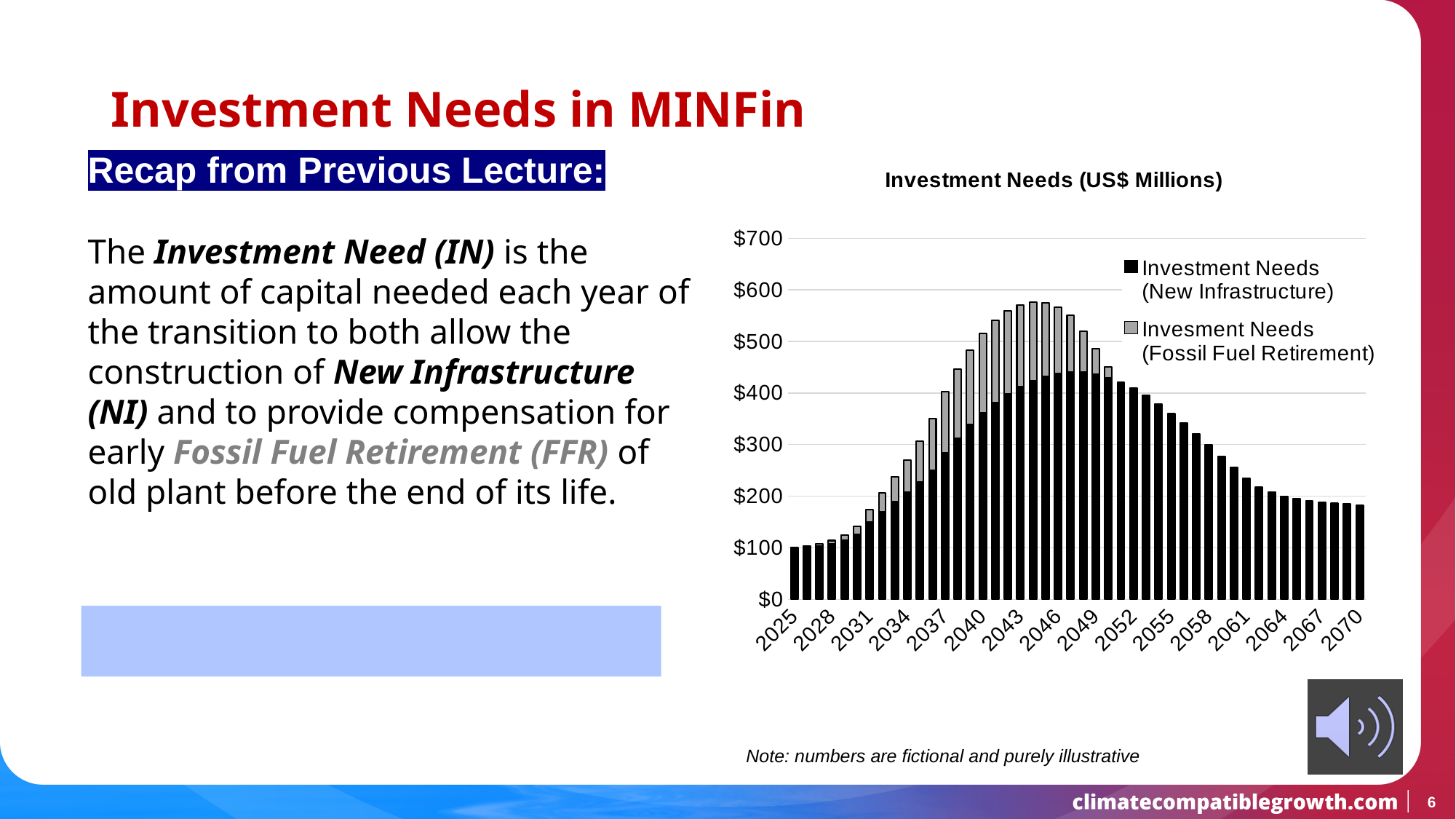
How many series does the chart's legend list? 2 Is the total investment need for 2046 greater or less than $500? greater Is the total investment need for 2025 greater or less than $200? less Which year has the larger total investment need, 2031 or 2046? 2046 What is the title of the chart? Investment Needs (US$ Millions) What kind of chart is shown on the slide? bar chart Is the total investment need for 2040 greater or less than $400? greater Which series is shown in grey in the chart? Invesment Needs (Fossil Fuel Retirement) Which year has the lowest total investment need? 2025 Do the total investment needs rise or fall from 2049 to 2070? fall